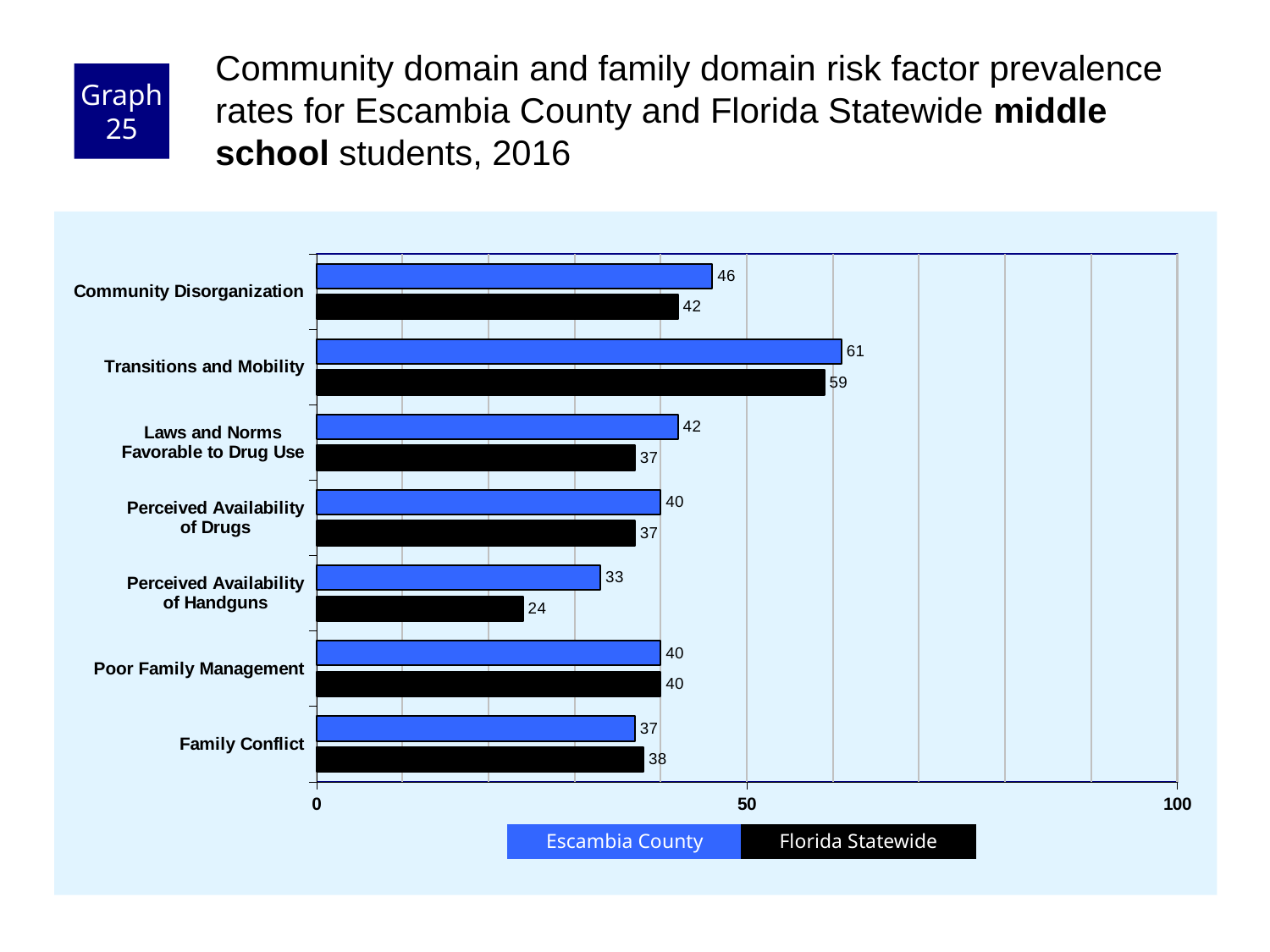
How many series does the legend list? 2 What is the Escambia County value for Transitions and Mobility? 61 For Family Conflict, which is larger: the Escambia County value or the Florida Statewide value? Florida Statewide What is the Florida Statewide value for Family Conflict? 38 What is the difference between the Escambia County and Florida Statewide values for Community Disorganization? 4 Which risk factor has the highest Escambia County value? Transitions and Mobility What is the Florida Statewide value for Perceived Availability of Handguns? 24 What kind of chart is shown on the slide? bar chart Which risk factor has the lowest Florida Statewide value? Perceived Availability of Handguns How many risk factors are shown on the chart? 7 What is the difference between the Escambia County and Florida Statewide values for Perceived Availability of Handguns? 9 Is the Escambia County value for Transitions and Mobility greater or less than 50? greater